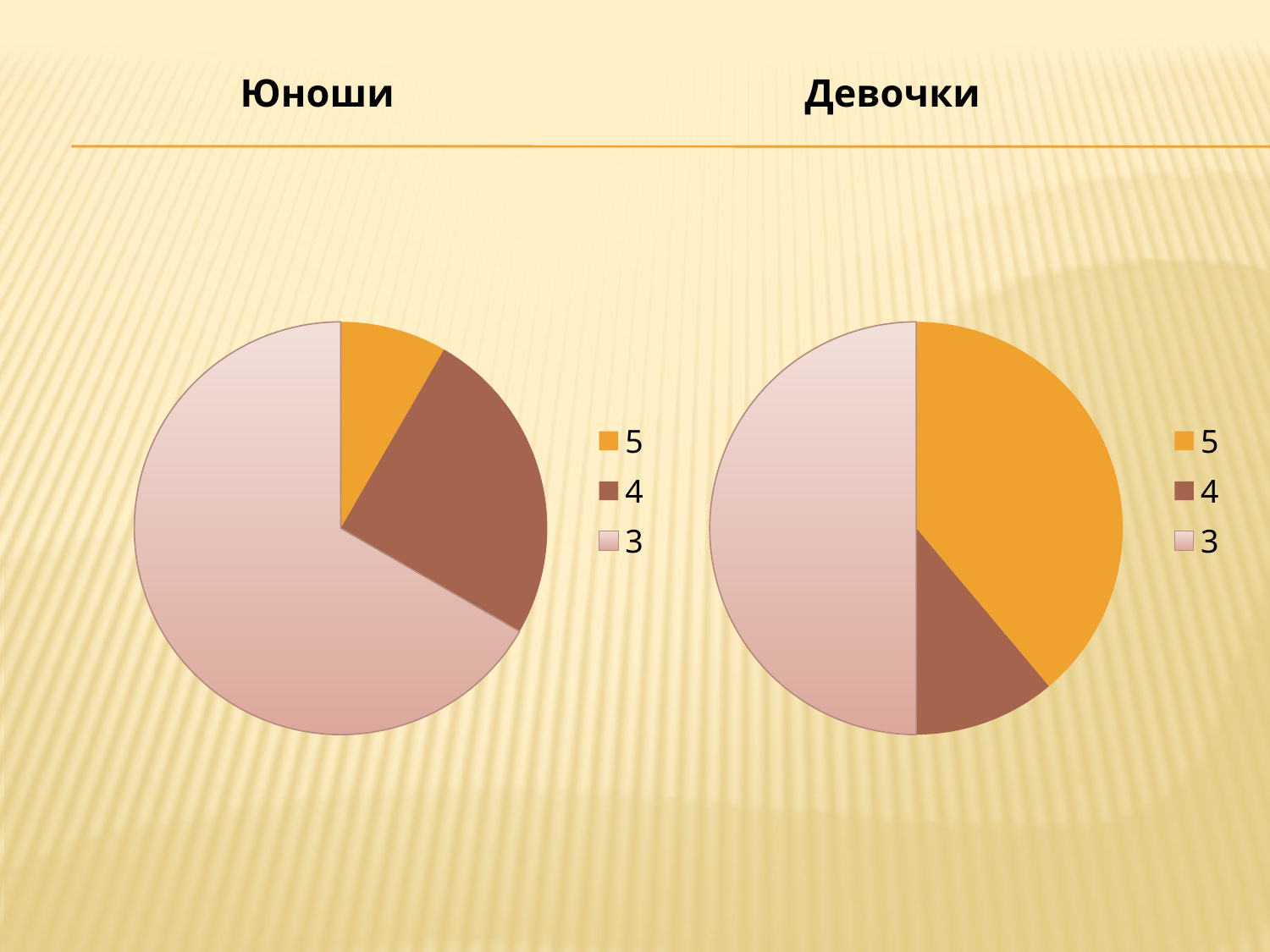
In the "Девочки" chart, which slice is larger, 5 or 4? 5 In the "Девочки" chart, what colour is the slice for category 5? orange In the "Юноши" chart, which slice is larger, 4 or 5? 4 How many entries does the legend of the "Девочки" chart list? 3 In the "Девочки" chart, which category has the largest slice? 3 What kind of chart is the "Девочки" chart? pie chart In the "Юноши" chart, which category has the largest slice? 3 In the "Юноши" chart, which category has the smallest slice? 5 In the "Девочки" chart, which category has the smallest slice? 4 How many slices does the "Юноши" pie chart have? 3 What kind of chart is the "Юноши" chart? pie chart What is the title of the chart on the left? Юноши